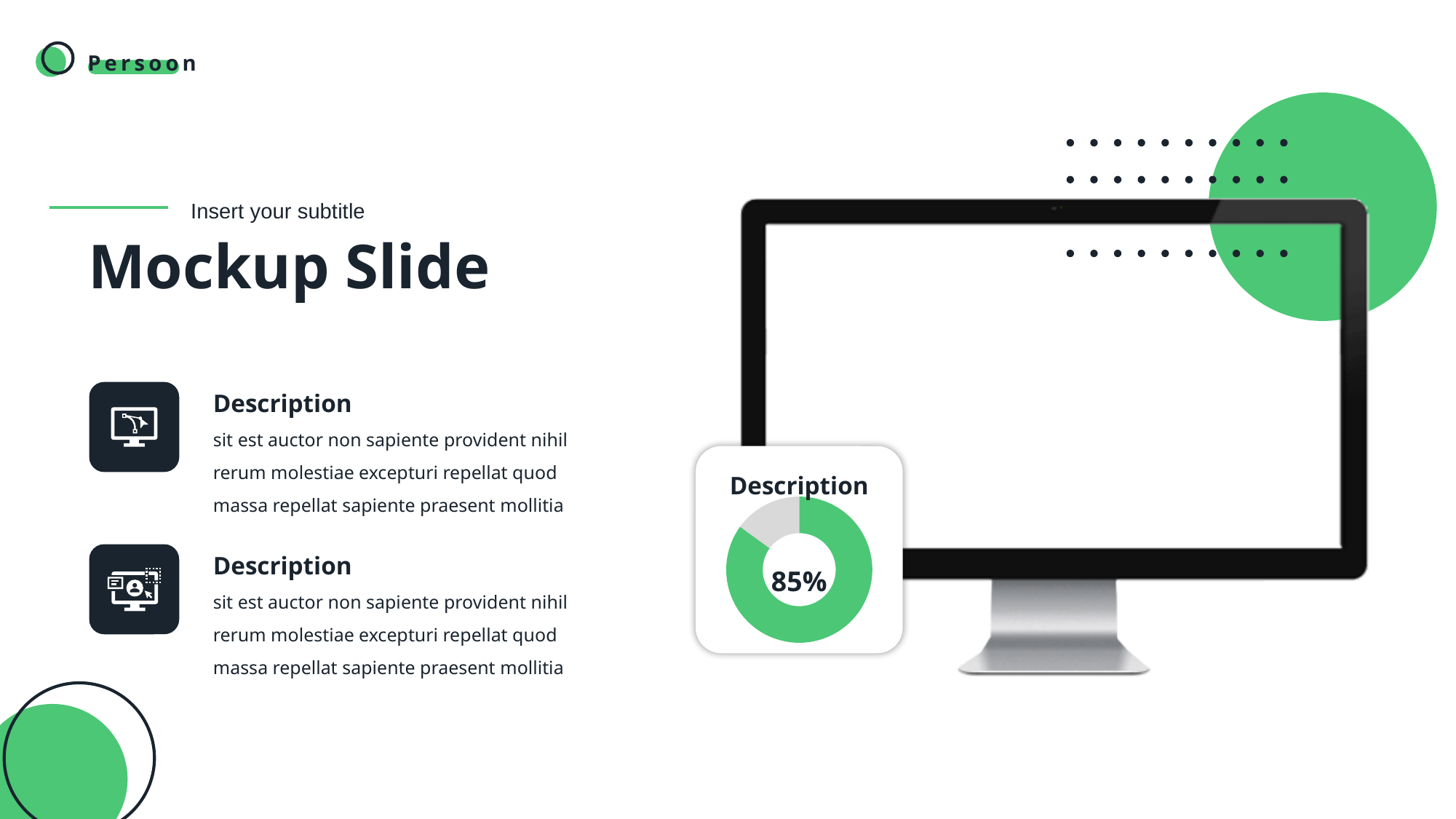
What is the title shown above the donut chart? Description What colour is the largest slice of the donut chart? green What kind of chart is shown in the card labelled "Description" in front of the monitor? donut chart What percentage is printed in the centre of the donut chart? 85% How many slices does the donut chart have? 2 Which slice of the donut chart is larger, the green one or the grey one? green How many charts are on the slide? 1 What share of the donut chart does the grey slice represent? 15% Is the green slice of the donut chart greater or less than 50%? greater Which slice of the donut chart is the smallest? the grey slice